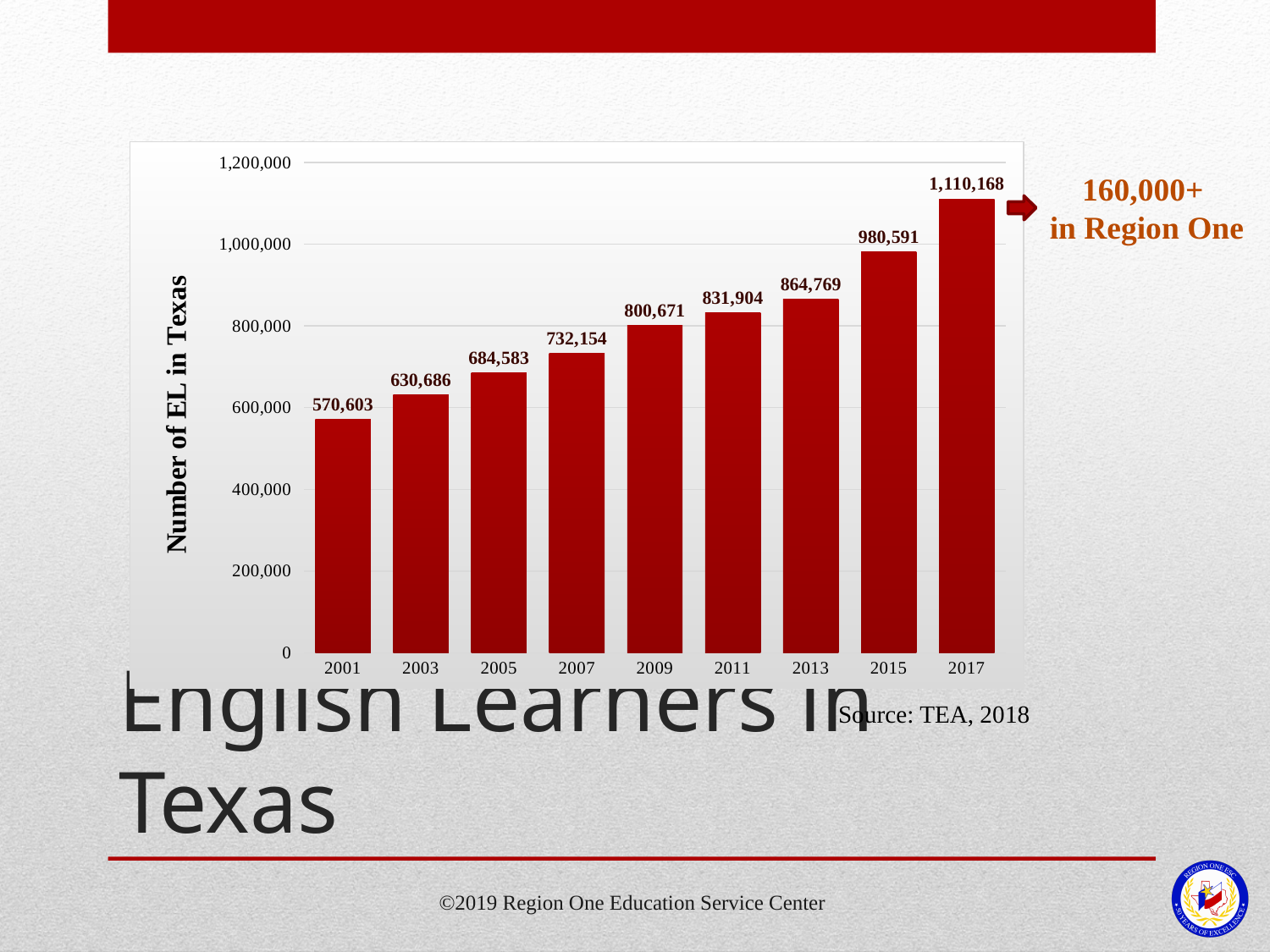
Is the value for 2013 greater or less than 800,000? greater What is the difference between the number of EL in Texas in 2015 and in 2013? 115,822 What is the number of EL in Texas for 2017? 1,110,168 Which year has the highest number of EL in Texas? 2017 How many years are shown on the x axis of the chart? 9 Which year has the lowest number of EL in Texas? 2001 What is the number of EL in Texas for 2009? 800,671 What is the number of EL in Texas for 2001? 570,603 Which year has a larger number of EL in Texas, 2007 or 2011? 2011 What is the difference between the number of EL in Texas in 2017 and in 2001? 539,565 What kind of chart is shown on the slide? Bar chart Do the values rise or fall from 2001 to 2017? Rise